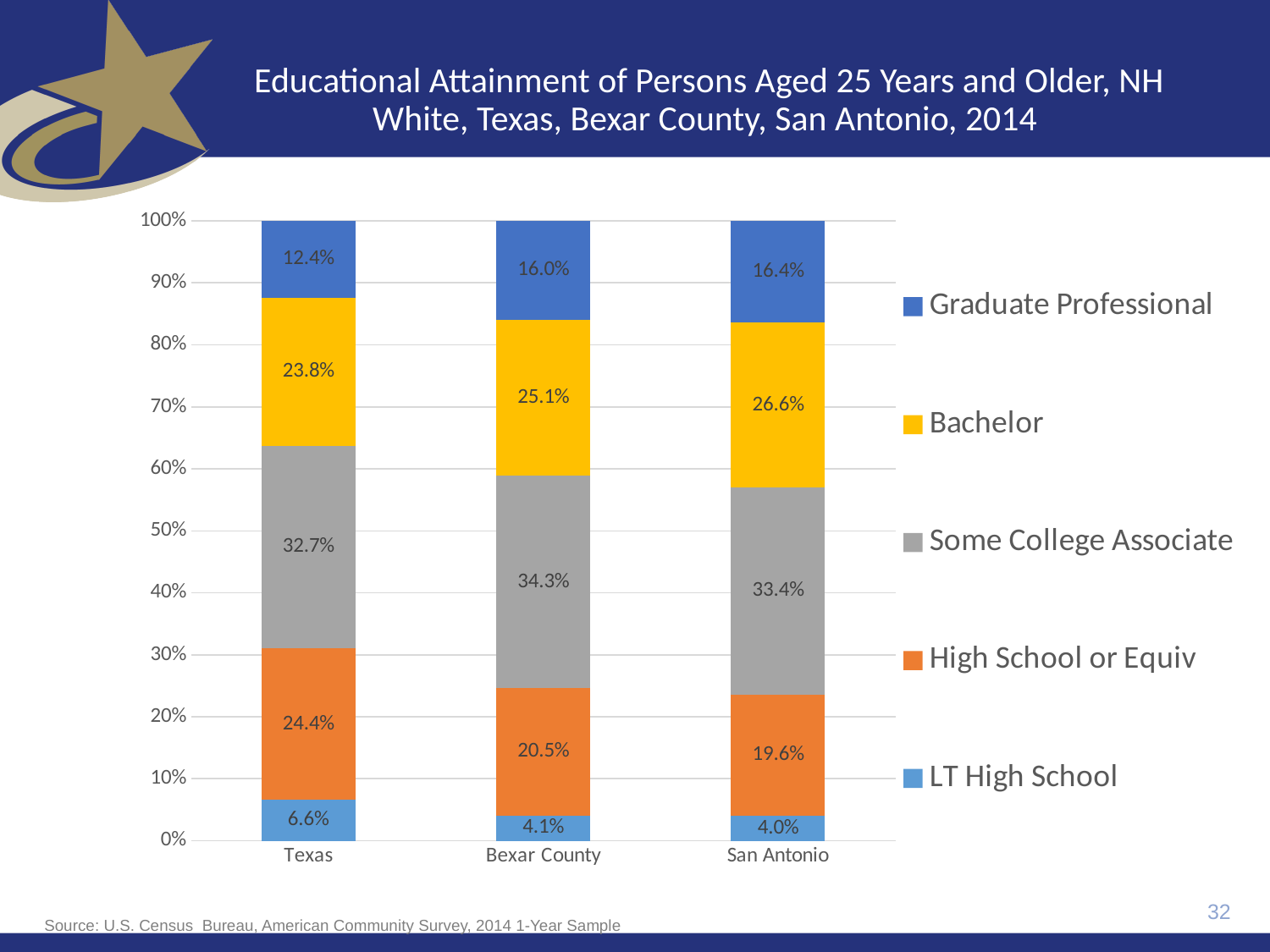
Is the Some College Associate value for Texas greater or less than 30%? greater What kind of chart is shown on the slide? Stacked bar chart Which has a larger Bachelor share, Texas or Bexar County? Bexar County Which geography has the highest Some College Associate share? Bexar County What is the Graduate Professional value for Bexar County? 16.0% What colour represents the Bachelor series in the legend? Yellow What is the difference between the High School or Equiv values for Texas and San Antonio? 4.8% What percentage of NH White persons aged 25 and older in San Antonio have a Bachelor degree? 26.6% How many series does the legend list? 5 What is the LT High School value for Texas? 6.6% How many geographies are shown on the x axis? 3 Which geography has the lowest Graduate Professional share? Texas